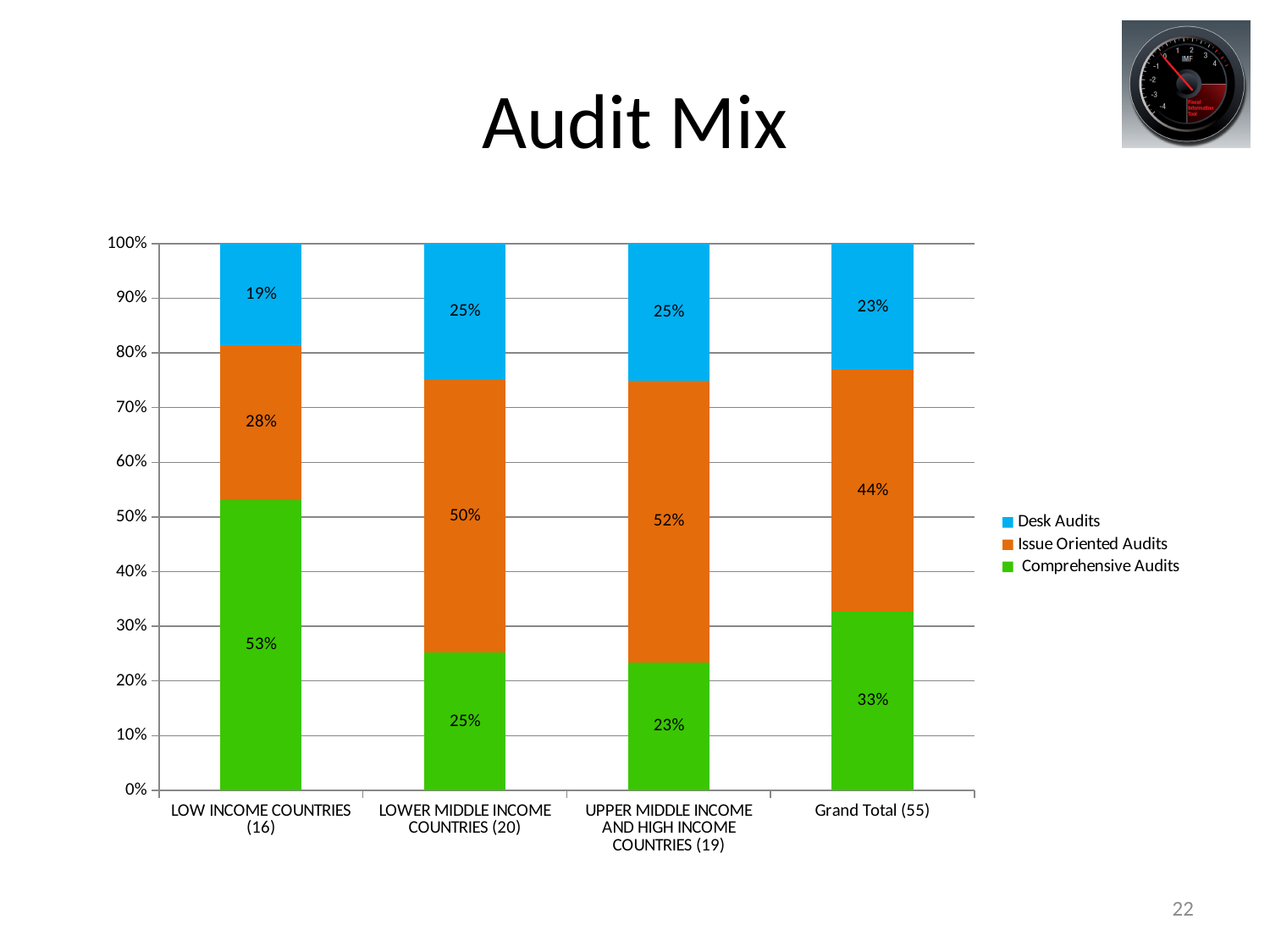
Which colour represents Desk Audits in the legend? Blue What is the difference between the Issue Oriented Audits share for Upper Middle Income and High Income Countries (19) and for Low Income Countries (16)? 24% What is the Issue Oriented Audits share for Upper Middle Income and High Income Countries (19)? 52% What is the Comprehensive Audits share for Lower Middle Income Countries (20)? 25% What kind of chart is shown on the slide? Stacked bar chart How many categories are shown on the x axis? 4 How many series does the legend list? 3 Which category has the highest Comprehensive Audits share? Low Income Countries (16) What is the Desk Audits share for the Grand Total (55)? 23% Which category has the lowest Desk Audits share? Low Income Countries (16) What percentage of audits in Low Income Countries (16) are Comprehensive Audits? 53% Which is larger for the Grand Total (55): the Issue Oriented Audits share or the Comprehensive Audits share? Issue Oriented Audits